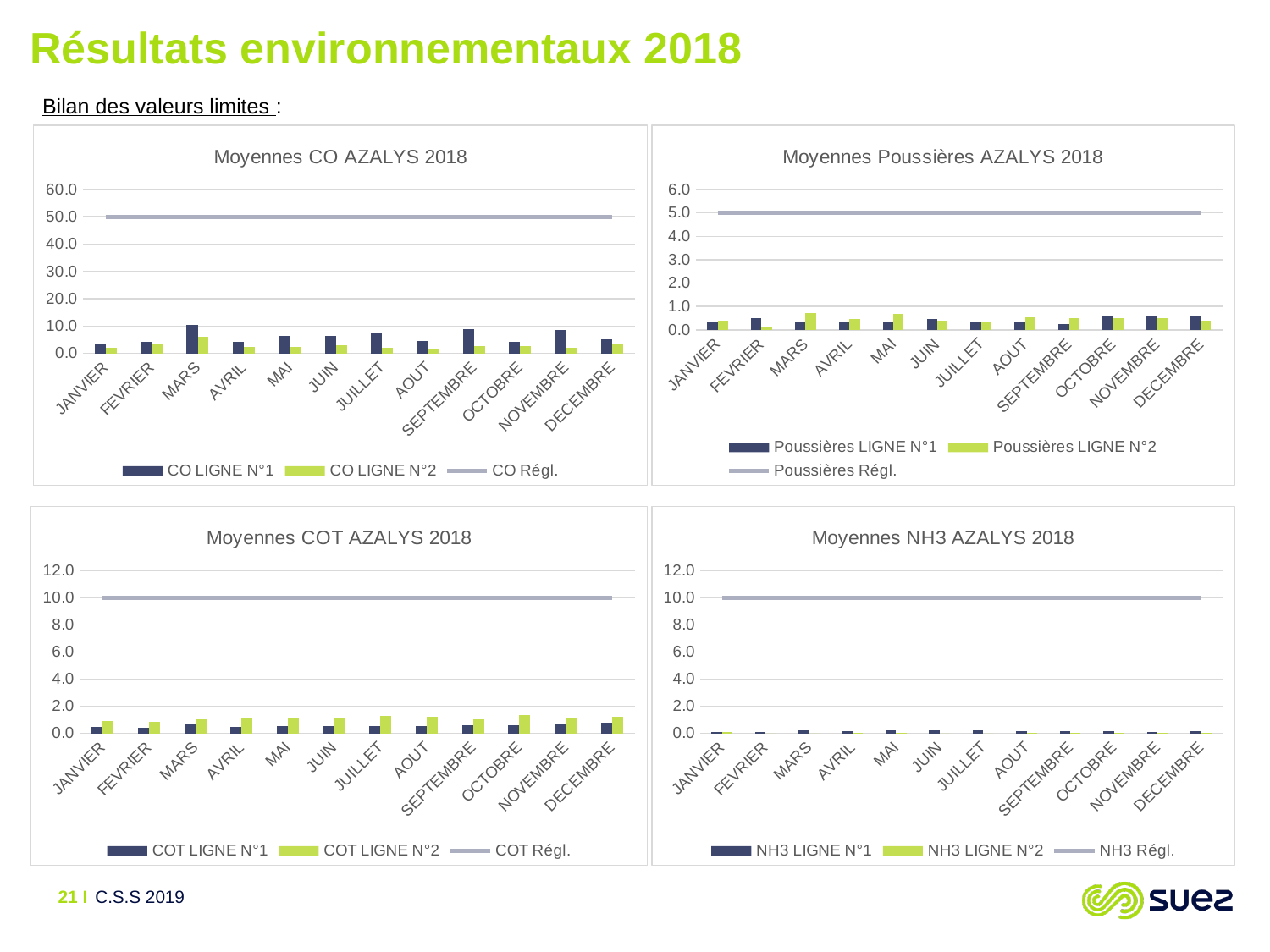
In the 'Moyennes CO AZALYS 2018' chart, is the value for CO LIGNE N°1 in MARS greater or less than 20.0? less In the 'Moyennes COT AZALYS 2018' chart, which is larger in JUILLET: COT LIGNE N°1 or COT LIGNE N°2? COT LIGNE N°2 In the 'Moyennes CO AZALYS 2018' chart, how many months are shown on the x axis? 12 How many series does the legend of the 'Moyennes Poussières AZALYS 2018' chart list? 3 In the 'Moyennes CO AZALYS 2018' chart, which is larger in MARS: CO LIGNE N°1 or CO LIGNE N°2? CO LIGNE N°1 In the 'Moyennes CO AZALYS 2018' chart, what value does the CO Régl. line sit at? 50.0 What kind of chart is the 'Moyennes CO AZALYS 2018' chart? Combination bar and line chart In the 'Moyennes Poussières AZALYS 2018' chart, what value does the Poussières Régl. line sit at? 5.0 In the 'Moyennes NH3 AZALYS 2018' chart, is the value for NH3 LIGNE N°1 in MARS greater or less than 2.0? less In the 'Moyennes COT AZALYS 2018' chart, what value does the COT Régl. line sit at? 10.0 In the 'Moyennes NH3 AZALYS 2018' chart, what value does the NH3 Régl. line sit at? 10.0 In the 'Moyennes CO AZALYS 2018' chart, which month has the highest value for CO LIGNE N°1? MARS